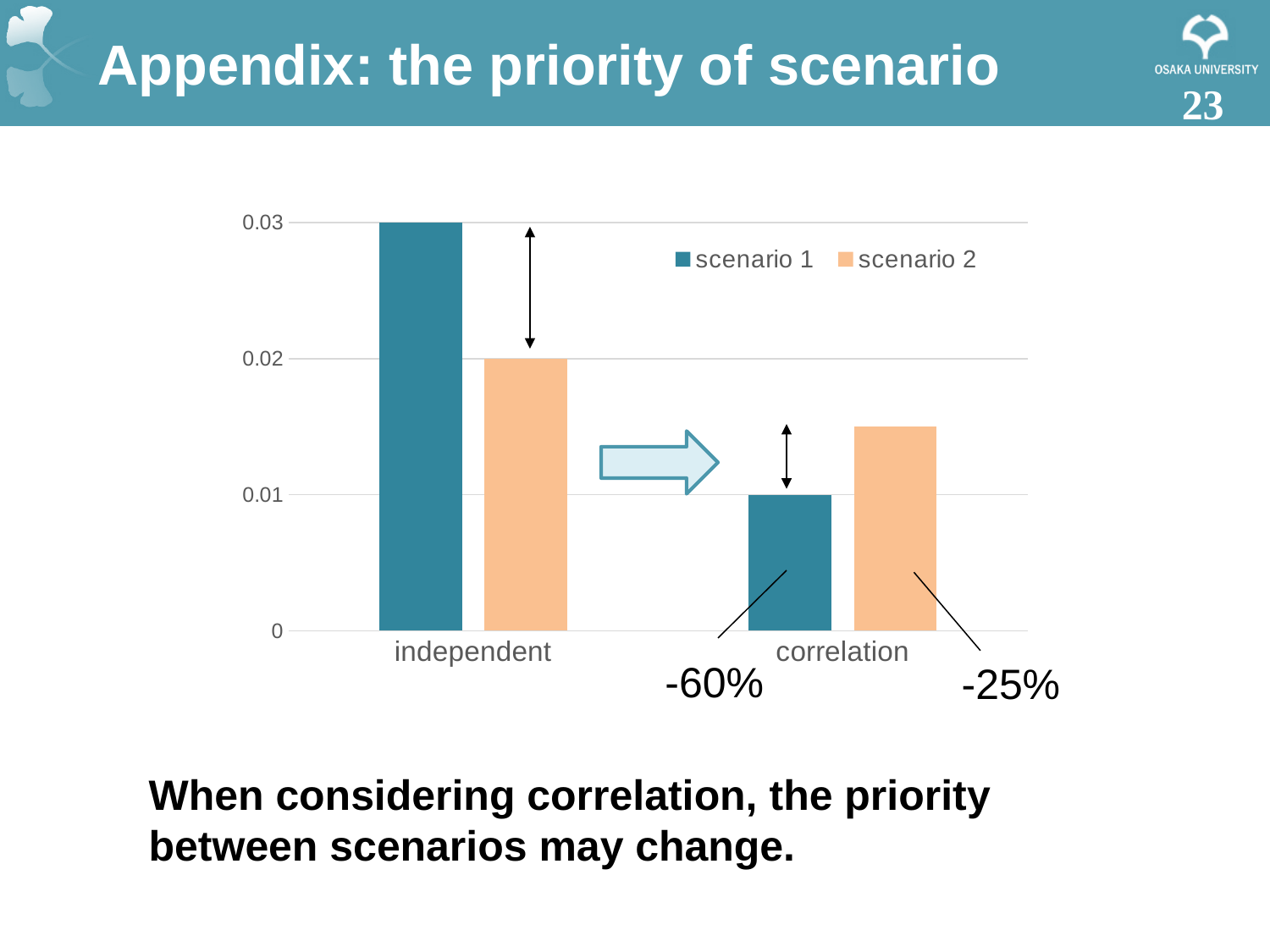
In the correlation category, which series has the larger value, scenario 1 or scenario 2? scenario 2 How many categories are shown on the x axis? 2 How many series does the legend list? 2 What is the difference between scenario 1 and scenario 2 in the independent category? 0.01 Is the value of scenario 2 for the correlation category greater or less than 0.01? greater What is the value of scenario 1 for the independent category? 0.03 What is the value of scenario 1 for the correlation category? 0.01 Is the value of scenario 2 for the correlation category greater or less than 0.02? less Does the value of scenario 1 rise or fall from independent to correlation? fall What is the value of scenario 2 for the independent category? 0.02 What type of chart is shown on the slide? bar chart What percentage change is annotated below the scenario 1 bar in the correlation category? -60%